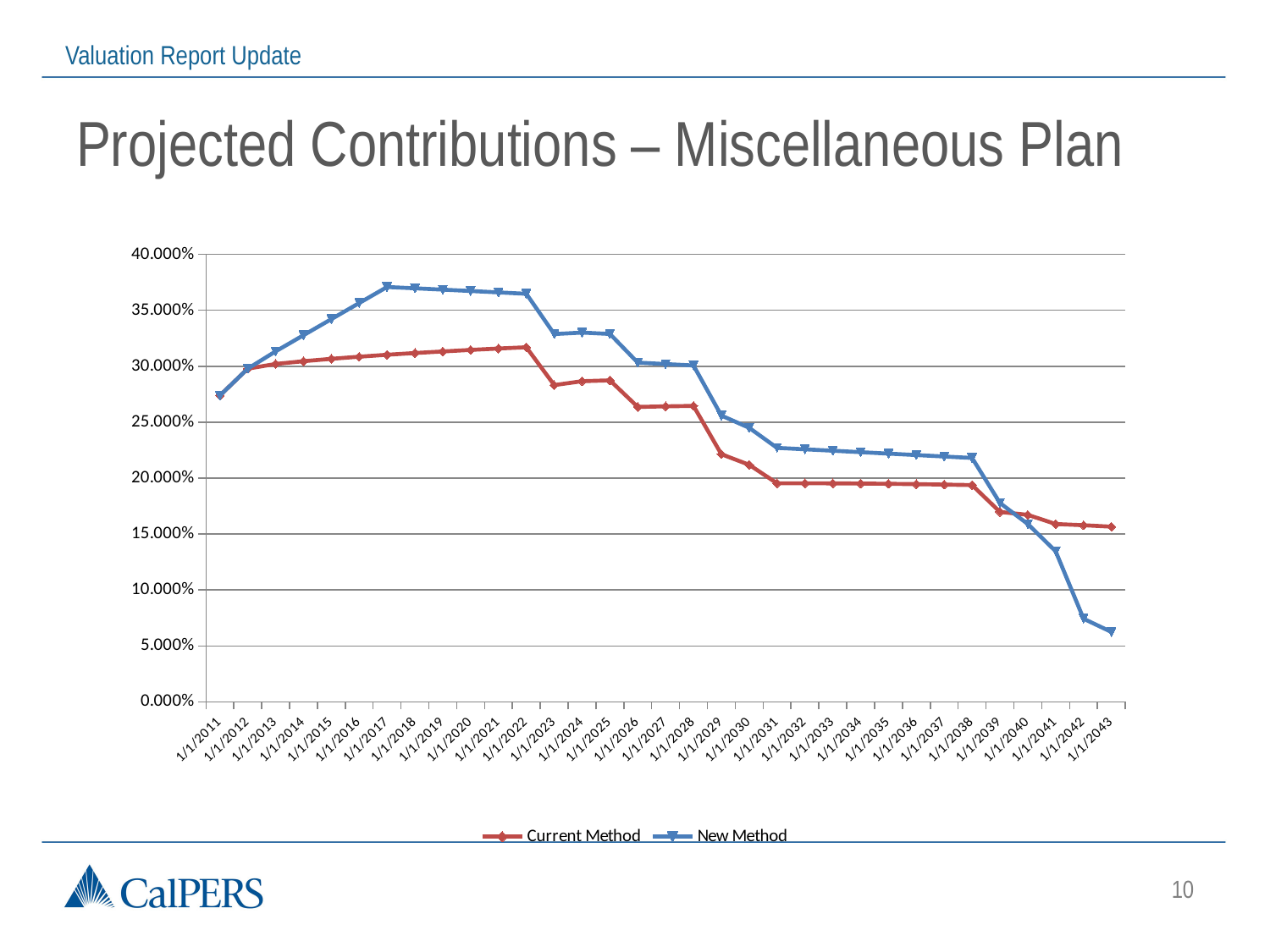
At 1/1/2043, which series has the higher value, Current Method or New Method? Current Method Is the value for Current Method at 1/1/2031 greater or less than 20.000%? less What are the two series named in the legend? Current Method and New Method At which date does the New Method series reach its highest value? 1/1/2017 How many dates are plotted along the x axis? 33 At which date does the New Method series reach its lowest value? 1/1/2043 What is the title of the slide containing the chart? Projected Contributions – Miscellaneous Plan Is the value for New Method at 1/1/2042 greater or less than 10.000%? less Is the value for New Method at 1/1/2017 greater or less than 35.000%? greater At 1/1/2020, which series has the higher value, Current Method or New Method? New Method What kind of chart is shown on the slide? Line chart How many series does the legend list? 2